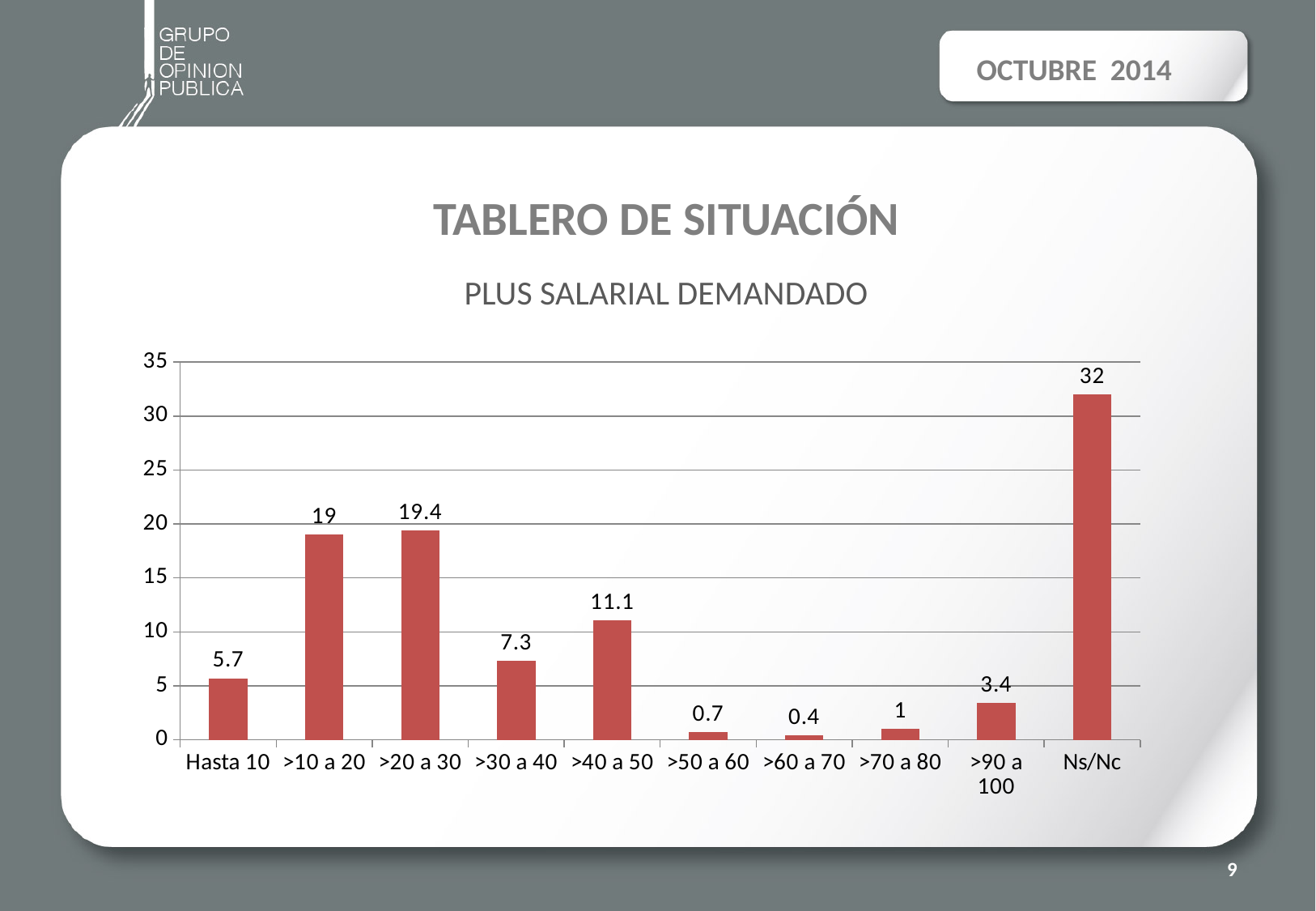
Which category has the highest value? Ns/Nc Which is larger, the value for ">40 a 50" or the value for ">30 a 40"? >40 a 50 What is the value for the ">20 a 30" category? 19.4 What is the difference between the values for "Ns/Nc" and ">10 a 20"? 13 What is the value for the "Hasta 10" category? 5.7 What kind of chart is shown on the slide? bar chart What is the subtitle of the chart? PLUS SALARIAL DEMANDADO How many categories are shown on the x axis? 10 What is the difference between the values for ">40 a 50" and ">30 a 40"? 3.8 Which category has the lowest value? >60 a 70 Is the value for "Ns/Nc" greater or less than 30? greater What is the value for the ">90 a 100" category? 3.4